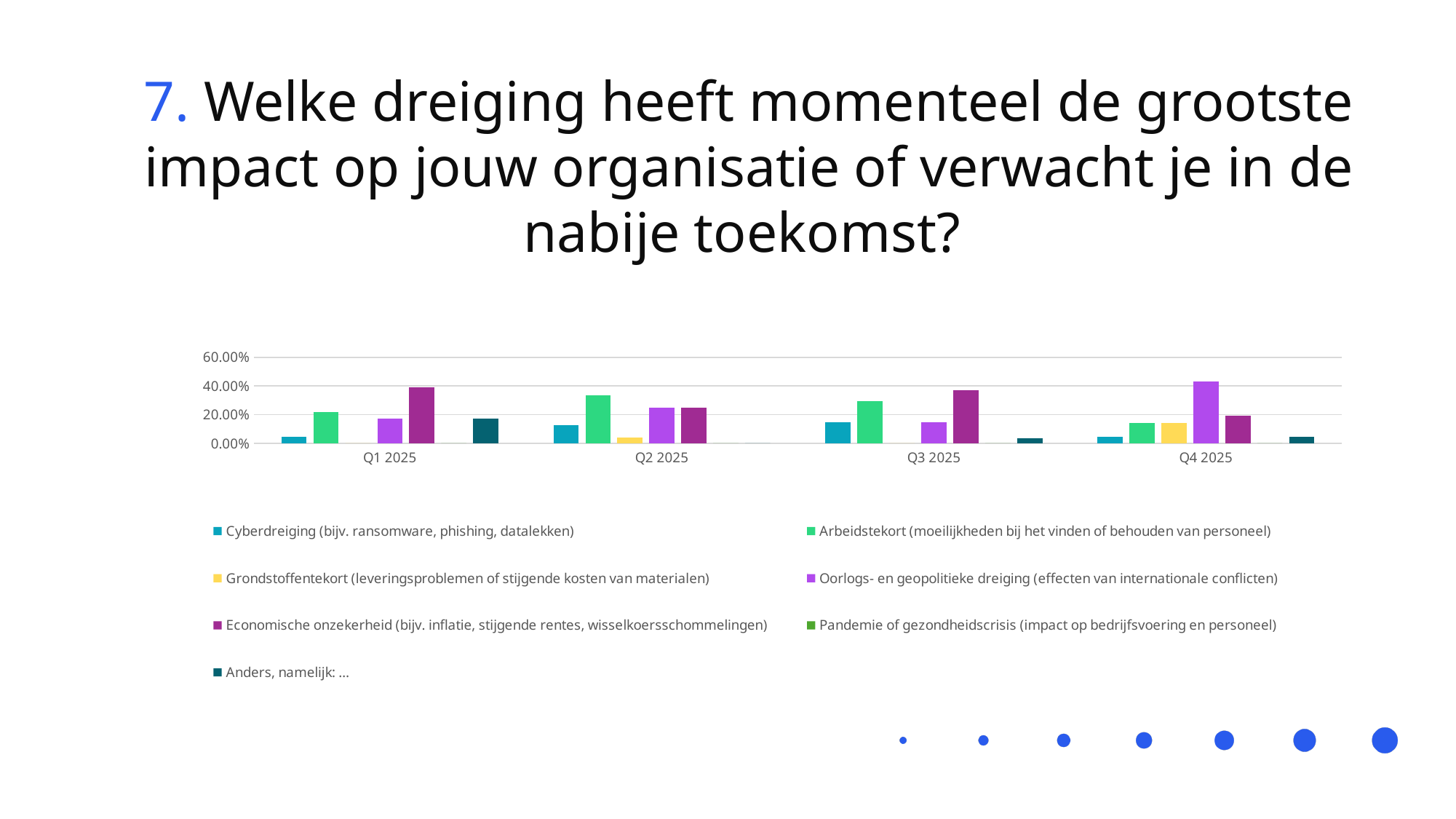
Which legend entry is shown in dark teal? Anders, namelijk: ... What kind of chart is shown on the slide? Bar chart In Q1 2025, which threat has the highest bar? Economische onzekerheid (bijv. inflatie, stijgende rentes, wisselkoersschommelingen) In Q2 2025, which threat has the highest bar? Arbeidstekort (moeilijkheden bij het vinden of behouden van personeel) In Q2 2025, which is larger: Arbeidstekort or Cyberdreiging? Arbeidstekort In Q4 2025, which is larger: Oorlogs- en geopolitieke dreiging or Economische onzekerheid? Oorlogs- en geopolitieke dreiging Is the value for Cyberdreiging in Q1 2025 greater or less than 20.00%? less In Q4 2025, which threat has the highest bar? Oorlogs- en geopolitieke dreiging (effecten van internationale conflicten) How many series does the chart's legend list? 7 Is the value for Economische onzekerheid in Q3 2025 greater or less than 20.00%? greater How many quarters are shown on the x axis of the chart? 4 Is the value for Oorlogs- en geopolitieke dreiging in Q4 2025 greater or less than 40.00%? greater